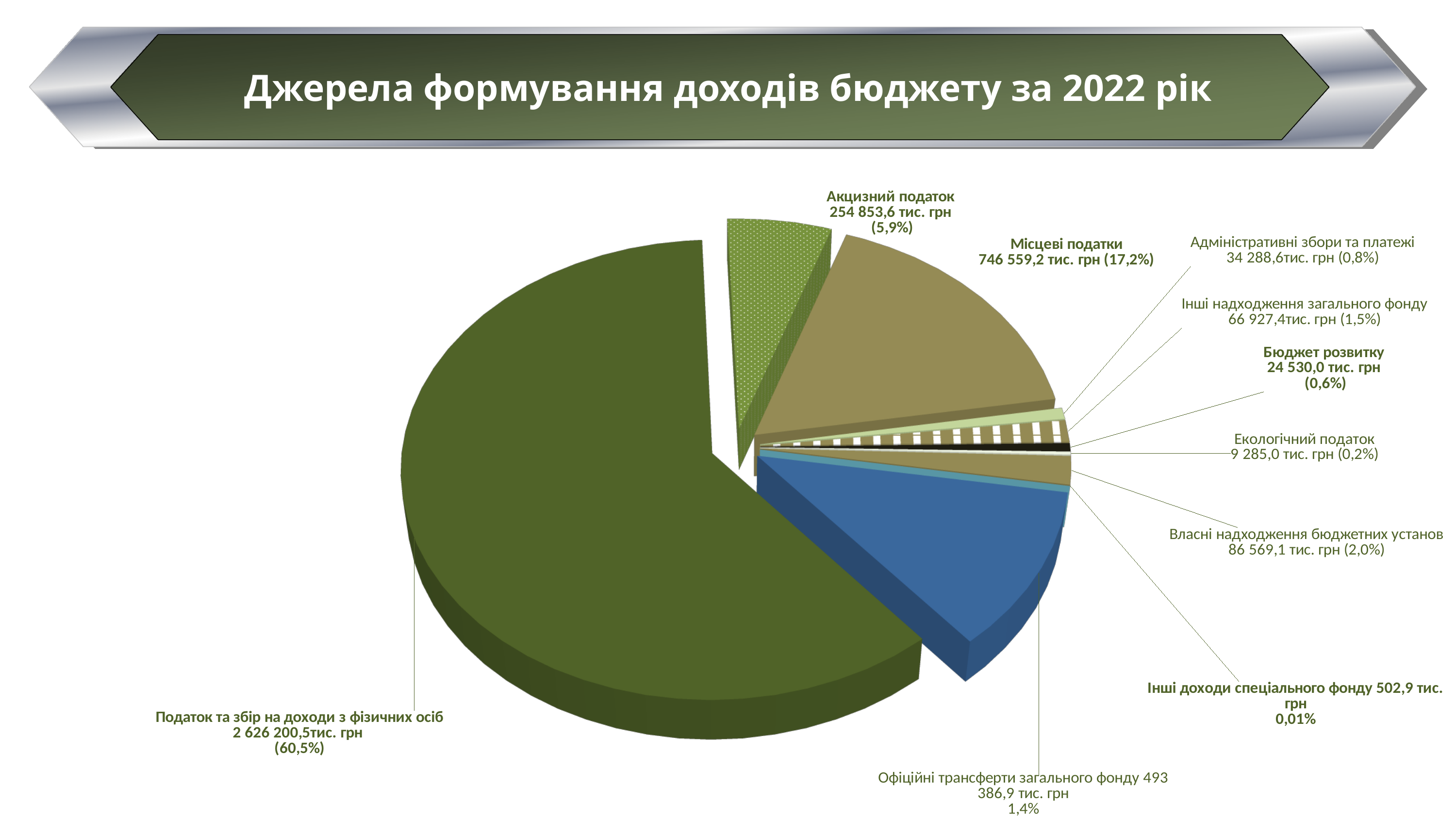
Which category has the largest share of the pie? Податок та збір на доходи з фізичних осіб How many categories (slices) does the pie chart have? 10 What is the value for Місцеві податки? 746 559,2 тис. грн What share of the pie does Податок та збір на доходи з фізичних осіб represent? 60,5% Which category has the smallest share of the pie? Інші доходи спеціального фонду What share of the pie does Бюджет розвитку represent? 0,6% Which is larger: Власні надходження бюджетних установ or Інші надходження загального фонду? Власні надходження бюджетних установ What is the value for Акцизний податок? 254 853,6 тис. грн What is the title of the slide? Джерела формування доходів бюджету за 2022 рік What is the value for Екологічний податок? 9 285,0 тис. грн What kind of chart is shown on the slide? Pie chart What is the difference between Місцеві податки and Акцизний податок? 491 705,6 тис. грн